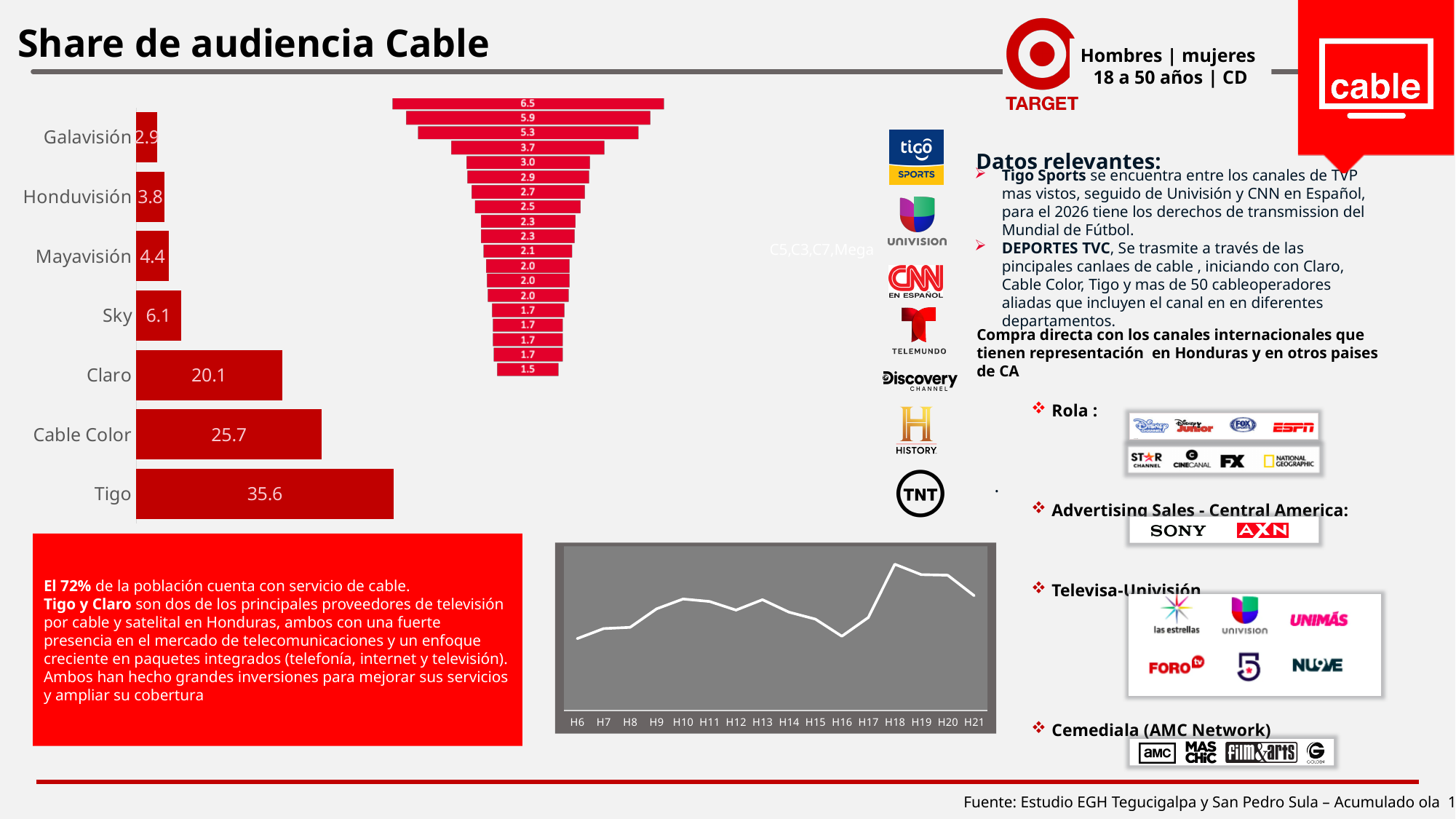
In the bar chart on the left, what is the value for Tigo? 35.6 In the bar chart on the left, which category has the highest value? Tigo In the bar chart on the left, what is the value for Sky? 6.1 In the bar chart on the left, which is larger, the value for Mayavisión or the value for Honduvisión? Mayavisión In the bar chart on the left, what is the difference between the values for Tigo and Claro? 15.5 In the funnel chart in the middle of the slide, what is the largest value shown? 6.5 In the bar chart on the left, which category has the lowest value? Galavisión How many bars does the funnel chart in the middle of the slide contain? 19 How many categories does the bar chart on the left show? 7 What kind of chart is the chart on the left of the slide? Bar chart In the line chart at the bottom, is the value at H18 higher or lower than the value at H6? Higher In the bar chart on the left, what is the value for Cable Color? 25.7